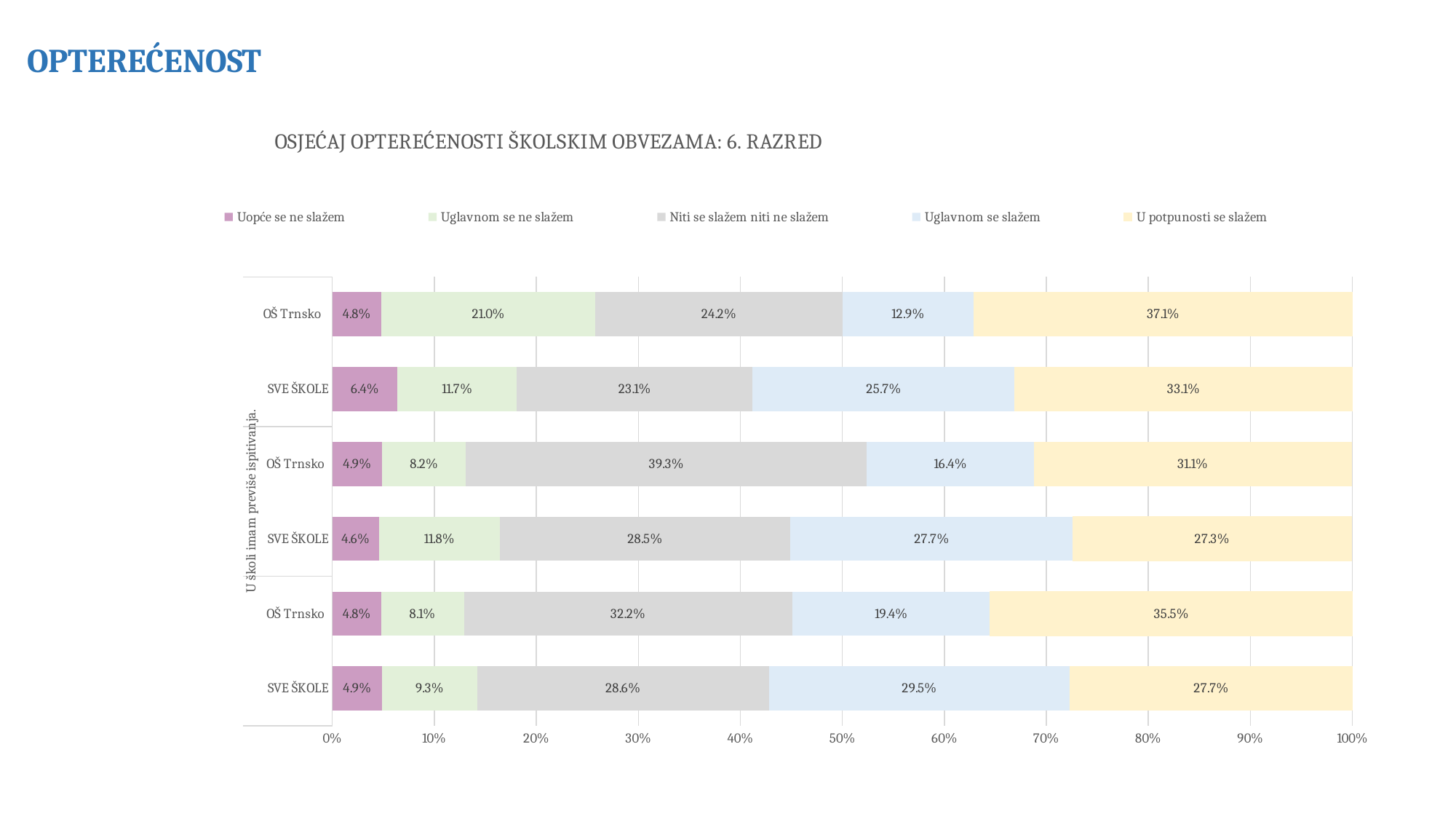
In the top bar (OŠ Trnsko), what is the value for "U potpunosti se slažem"? 37.1% What is the title of the chart? OSJEĆAJ OPTEREĆENOSTI ŠKOLSKIM OBVEZAMA: 6. RAZRED How many bars are plotted in the chart? 6 In the third bar from the top (OŠ Trnsko), what is the value for "Uglavnom se ne slažem"? 8.2% Which bar has the lowest value for "Uopće se ne slažem"? The fourth bar from the top (SVE ŠKOLE), 4.6% What text is written along the vertical axis of the chart? U školi imam previše ispitivanja. How many series does the legend list? 5 In the bottom bar (SVE ŠKOLE), what is the value for "Uglavnom se slažem"? 29.5% What kind of chart is shown on the slide? Stacked bar chart In the second bar from the top (SVE ŠKOLE), which is larger: "Uglavnom se slažem" or "Niti se slažem niti ne slažem"? Uglavnom se slažem In the top bar (OŠ Trnsko), what is the difference between "U potpunosti se slažem" and "Uglavnom se slažem"? 24.2 percentage points Which bar has the highest value for "Niti se slažem niti ne slažem"? The third bar from the top (OŠ Trnsko), 39.3%